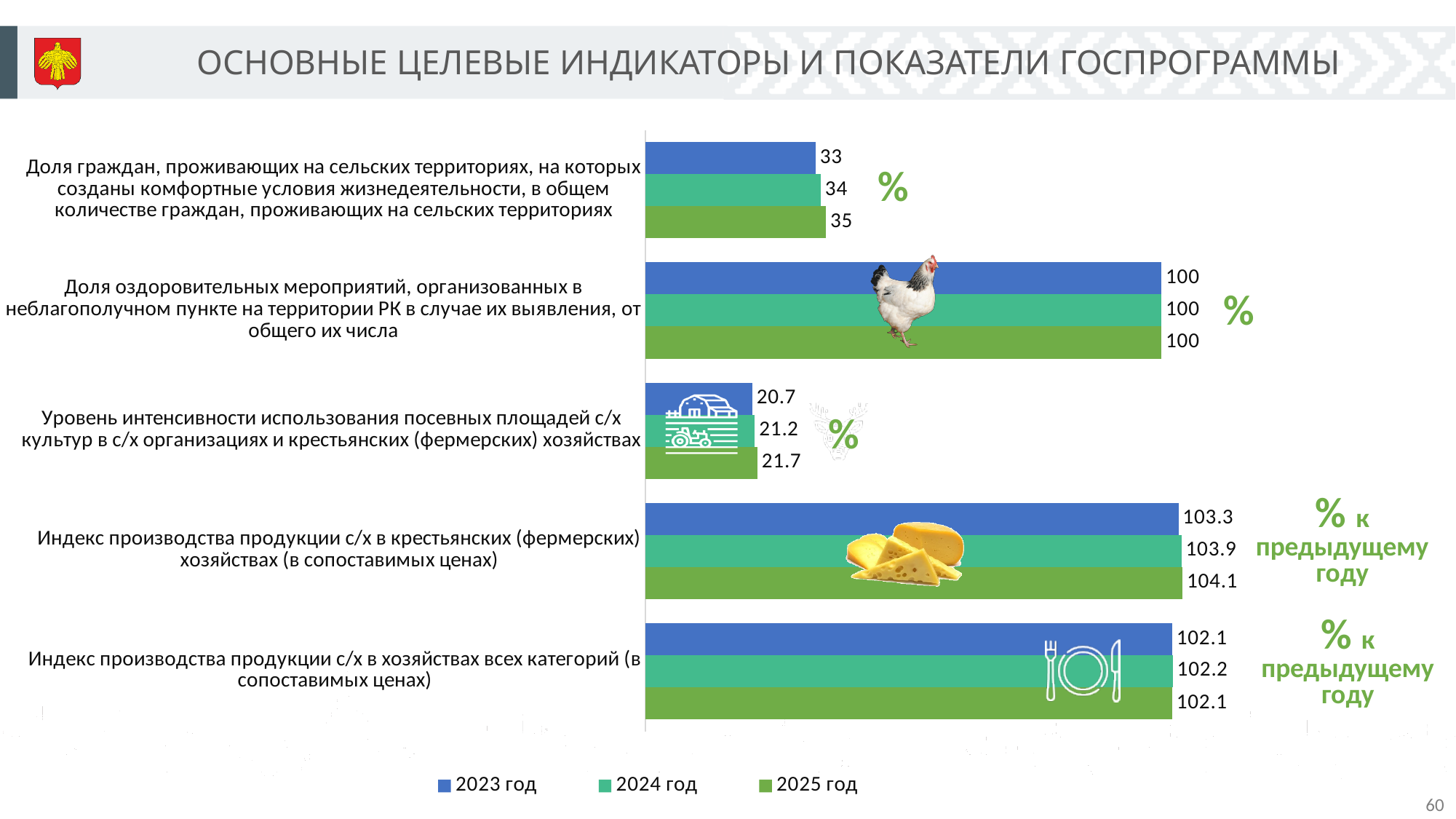
What are the legend entries of the chart? 2023 год, 2024 год, 2025 год What is the 2024 год value for «Индекс производства продукции с/х в крестьянских (фермерских) хозяйствах (в сопоставимых ценах)»? 103.9 By how much does the 2025 год value exceed the 2023 год value for «Доля граждан, проживающих на сельских территориях...»? 2 What is the 2025 год value for «Уровень интенсивности использования посевных площадей с/х культур в с/х организациях и крестьянских (фермерских) хозяйствах»? 21.7 How many indicator categories are shown on the chart? 5 What is the 2024 год value for «Доля оздоровительных мероприятий, организованных в неблагополучном пункте на территории РК...»? 100 What is the 2023 год value for «Доля граждан, проживающих на сельских территориях, на которых созданы комфортные условия жизнедеятельности...»? 33 Which category has the lowest 2023 год value? Уровень интенсивности использования посевных площадей с/х культур в с/х организациях и крестьянских (фермерских) хозяйствах What kind of chart is shown on the slide? Bar chart How many series does the legend list? 3 For «Индекс производства продукции с/х в хозяйствах всех категорий (в сопоставимых ценах)», which year has the larger value: 2024 год or 2025 год? 2024 год Do the values for «Уровень интенсивности использования посевных площадей...» rise or fall from 2023 год to 2025 год? Rise